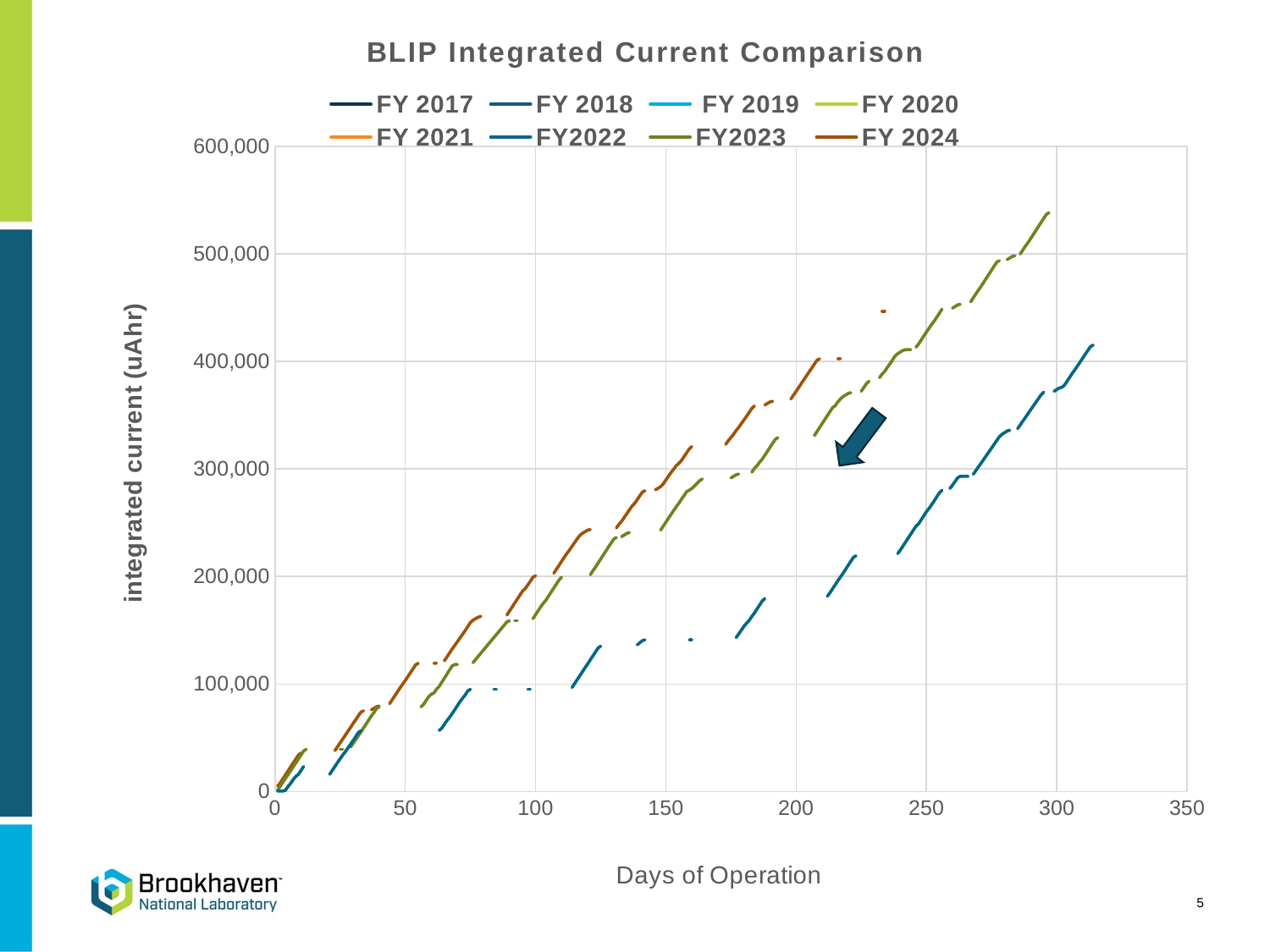
Is the final value of the FY2022 line greater or less than 400,000? greater Is the highest value reached by the FY2023 line greater or less than 500,000? greater How many series does the legend list? 8 At 200 days of operation, which series has the higher integrated current, FY 2024 or FY2023? FY 2024 What kind of chart is shown on the slide? line chart Is the FY 2024 value at 100 days of operation greater or less than 150,000? greater Which series reaches the highest integrated current on the chart? FY2023 At 250 days of operation, which series has the higher integrated current, FY2023 or FY2022? FY2023 What is the title of the chart? BLIP Integrated Current Comparison What is the label of the x axis? Days of Operation Does the FY2023 line rise or fall as days of operation increase? rise